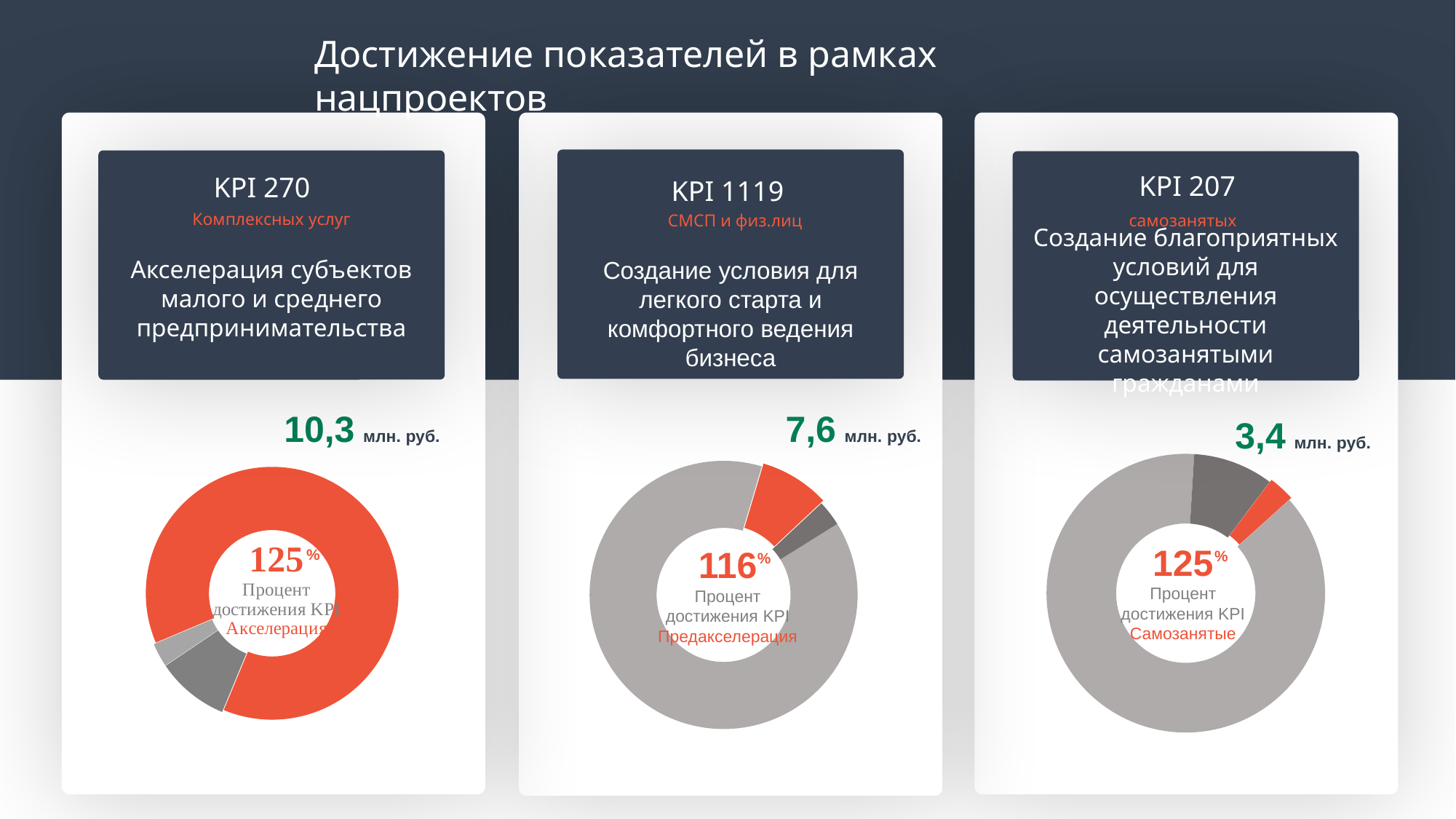
What is the difference in млн. руб. between the amounts shown for Акселерация (10,3) and Предакселерация (7,6)? 2,7 млн. руб. In the right chart (Самозанятые), what percentage of KPI achievement is shown in the centre? 125% What amount in млн. руб. is shown above the middle chart (Предакселерация)? 7,6 млн. руб. In the left chart (Акселерация), what colour is the largest slice of the donut? Orange (red-orange) In the middle chart (Предакселерация), what percentage of KPI achievement is shown in the centre? 116% Which chart shows the largest amount in млн. руб.: Акселерация or Самозанятые? Акселерация In the left chart (Акселерация), what percentage of KPI achievement is shown in the centre? 125% Which of the three charts has the lowest KPI achievement percentage in its centre? Предакселерация (116%) What type of chart is used on the slide for the KPI achievement percentages? Donut (pie) chart What amount in млн. руб. is shown above the left chart (Акселерация)? 10,3 млн. руб. How many donut charts are shown on the slide? 3 What amount in млн. руб. is shown above the right chart (Самозанятые)? 3,4 млн. руб.